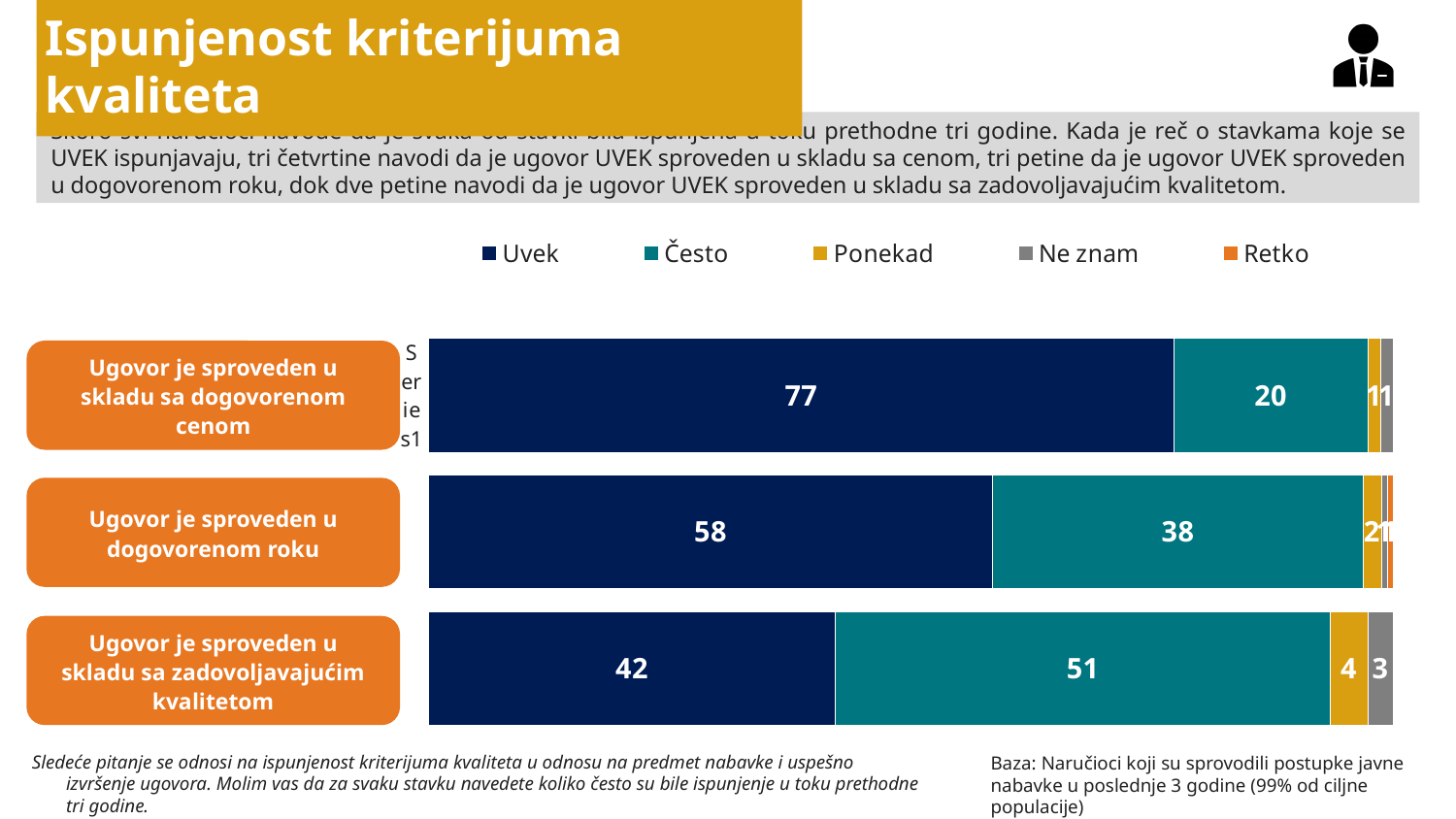
How many series does the legend list? 5 Which legend entry is shown in dark navy blue? Uvek Which category has the lowest "Uvek" value? Ugovor je sproveden u skladu sa zadovoljavajućim kvalitetom What is the value of "Uvek" for "Ugovor je sproveden u skladu sa dogovorenom cenom"? 77 How many categories (bars) does the chart show? 3 Which category has the highest "Uvek" value? Ugovor je sproveden u skladu sa dogovorenom cenom What kind of chart is shown on the slide? Stacked bar chart What is the value of "Često" for "Ugovor je sproveden u dogovorenom roku"? 38 What is the difference between the "Uvek" values for "Ugovor je sproveden u skladu sa dogovorenom cenom" and "Ugovor je sproveden u dogovorenom roku"? 19 What is the value of "Ponekad" for "Ugovor je sproveden u skladu sa zadovoljavajućim kvalitetom"? 4 What is the value of "Ne znam" for "Ugovor je sproveden u skladu sa zadovoljavajućim kvalitetom"? 3 For "Ugovor je sproveden u skladu sa zadovoljavajućim kvalitetom", which is larger: "Uvek" or "Često"? Često